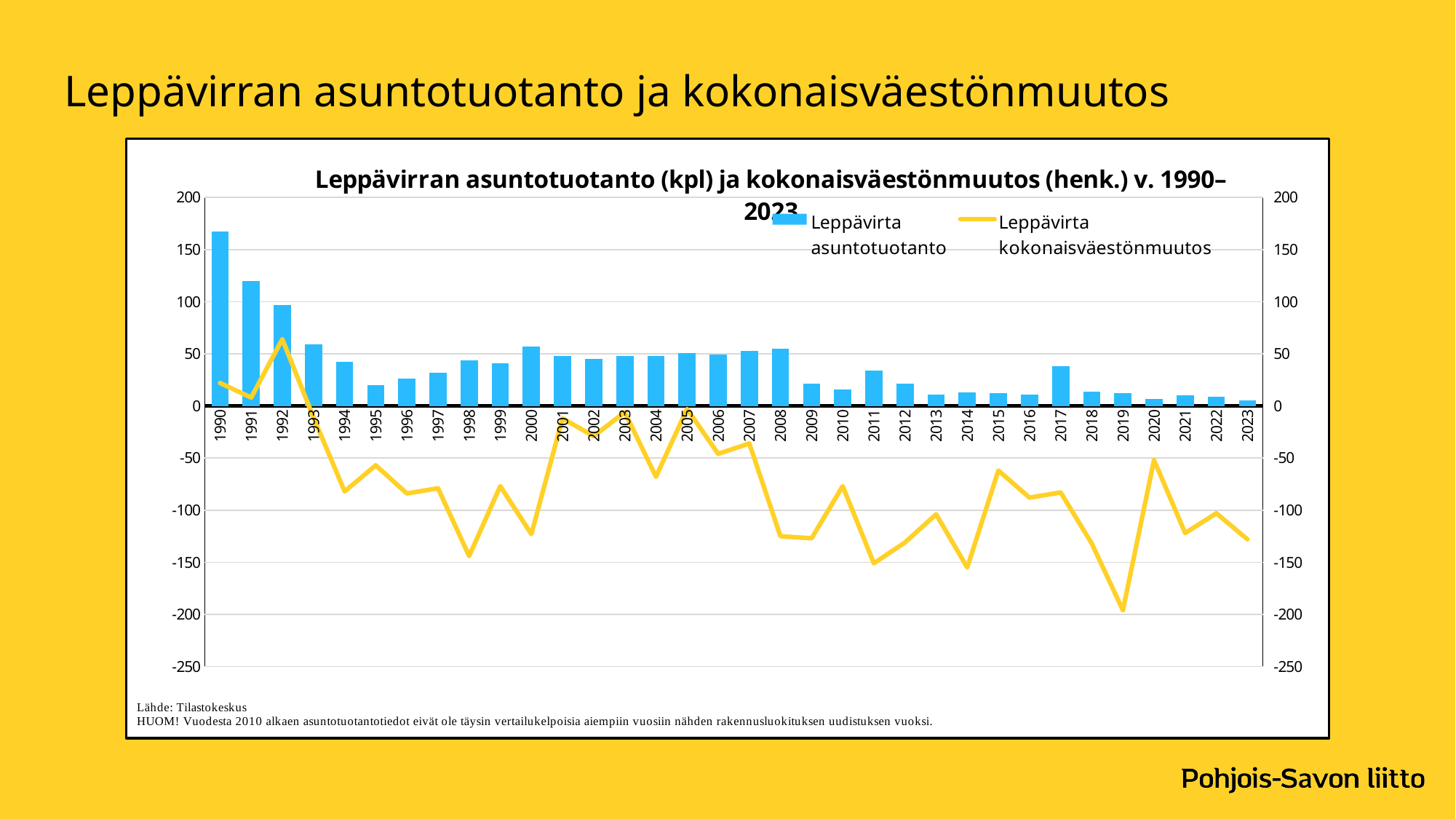
Is the value for Leppävirta kokonaisväestönmuutos in 2019 greater or less than -150? less How many years are shown on the x axis? 34 Which year has the lowest value for Leppävirta kokonaisväestönmuutos (the line)? 2019 Do the Leppävirta asuntotuotanto bars generally rise or fall from 1990 to 2023? fall Which year has the highest value for Leppävirta kokonaisväestönmuutos (the line)? 1992 Is the value for Leppävirta asuntotuotanto in 1990 greater or less than 150? greater Is the value for Leppävirta asuntotuotanto in 2009 greater or less than 50? less Which year has the highest value for Leppävirta asuntotuotanto (the bars)? 1990 What kind of chart is shown on the slide? A combined bar and line chart How many series does the legend list? 2 Which is larger, the Leppävirta asuntotuotanto bar for 2017 or for 2018? 2017 What colour is the Leppävirta kokonaisväestönmuutos line? Yellow